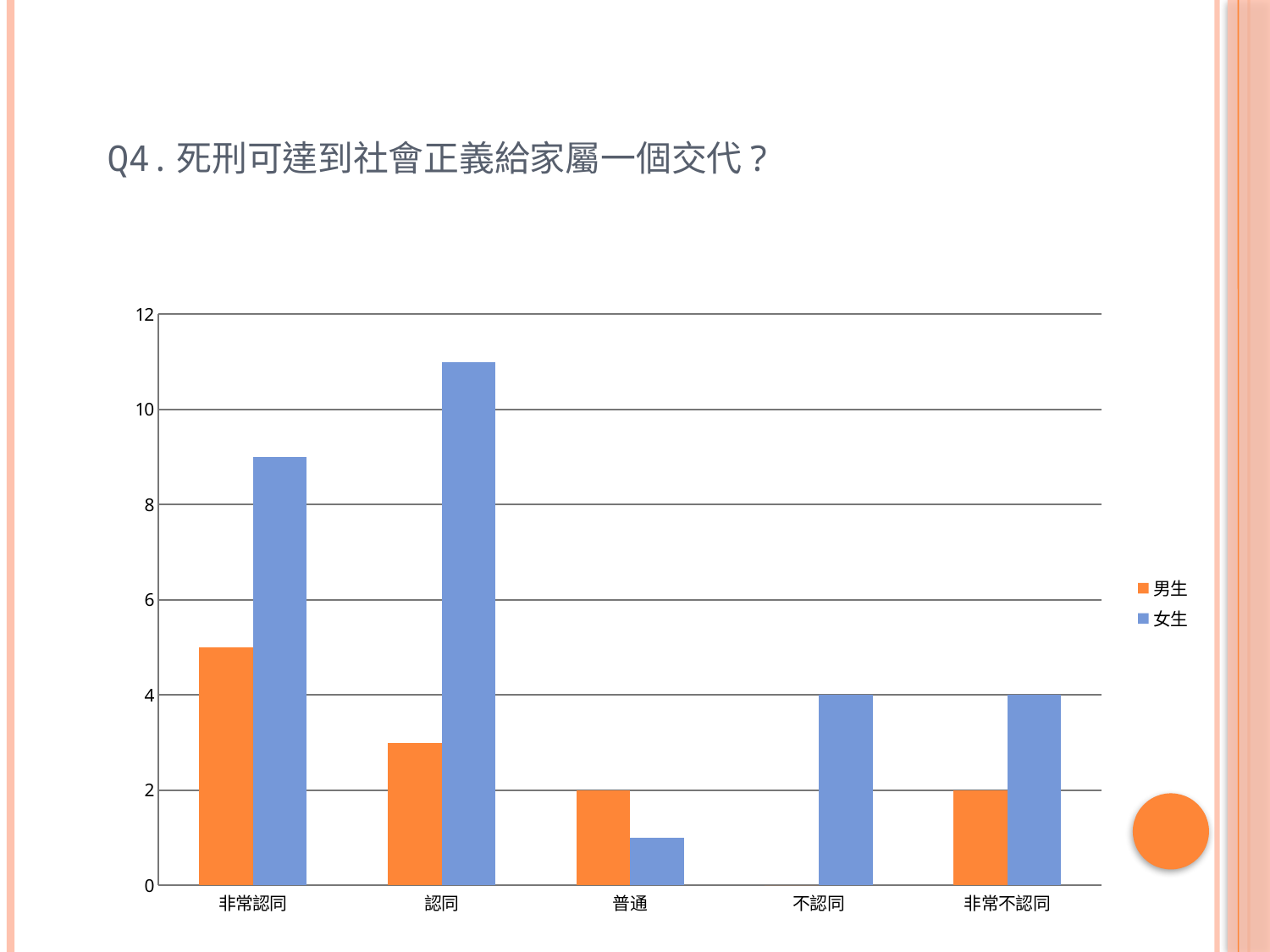
What is the difference between the 女生 value for 不認同 and the 男生 value for 非常不認同? 2 How many series does the legend list? 2 What is the value for 男生 in the 普通 category? 2 How many categories are shown on the x axis? 5 Is the value for 女生 in the 認同 category greater or less than 10? greater Which category has the highest value for 男生? 非常認同 What is the value for 女生 in the 非常不認同 category? 4 What is the value for 女生 in the 不認同 category? 4 Which category has the highest value for 女生? 認同 What kind of chart is shown on the slide? bar chart Which category has the lowest value for 女生? 普通 In the 非常認同 category, which series has the larger value, 男生 or 女生? 女生